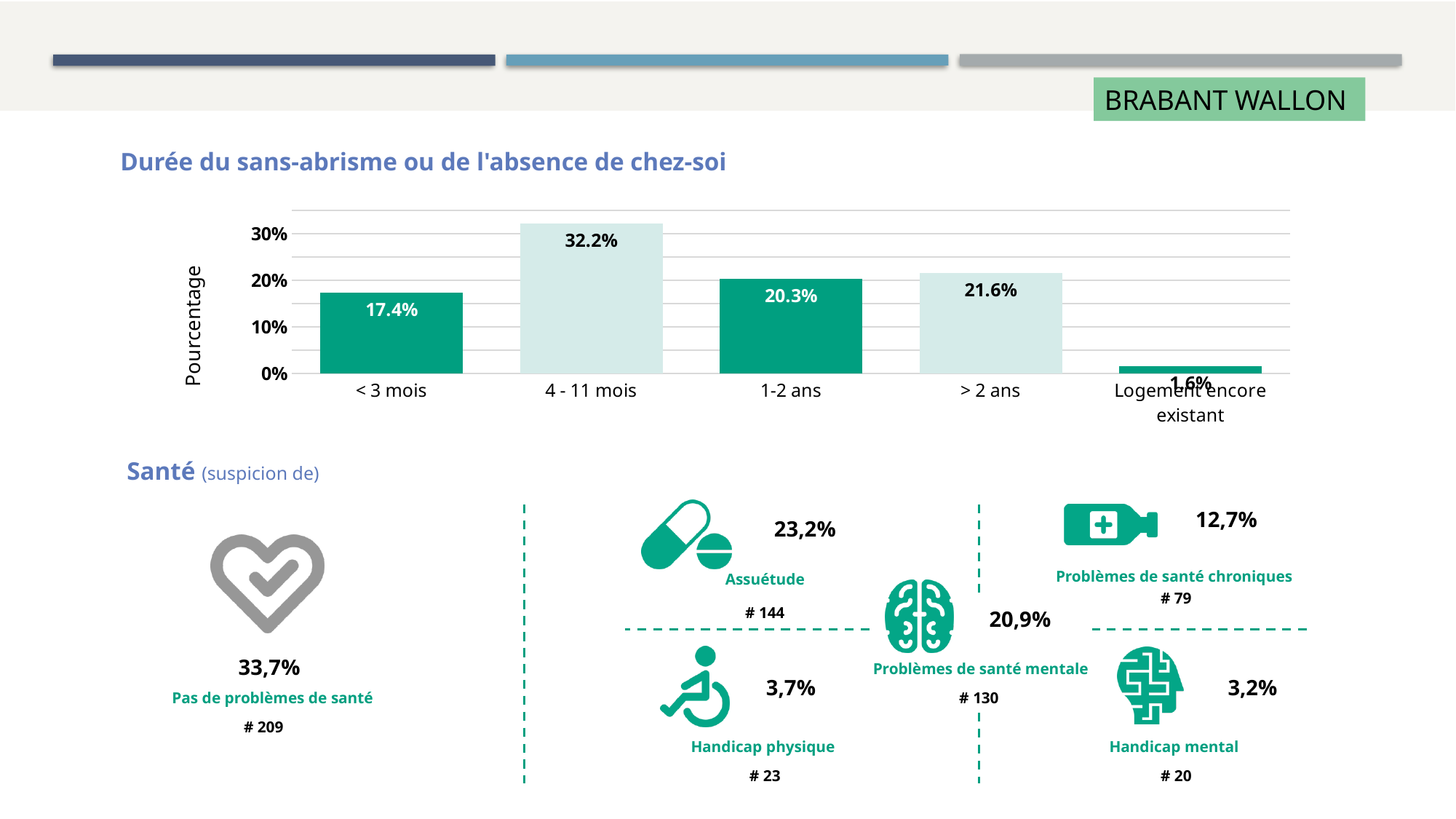
Is the value for "< 3 mois" greater or less than 20%? less What is the value for "< 3 mois" in the chart? 17.4% Which category has the lowest value in the chart? Logement encore existant How many categories are shown in the chart? 5 What is the value for "4 - 11 mois" in the chart "Durée du sans-abrisme ou de l'absence de chez-soi"? 32.2% What type of chart is shown under the title "Durée du sans-abrisme ou de l'absence de chez-soi"? bar chart Which category has the highest value in the chart? 4 - 11 mois Which is larger, the value for "> 2 ans" or the value for "1-2 ans"? > 2 ans What is the value for "1-2 ans" in the chart? 20.3% What is the value for "Logement encore existant" in the chart? 1.6% What is the value for "> 2 ans" in the chart? 21.6% What is the difference between the values for "4 - 11 mois" and "< 3 mois"? 14.8%